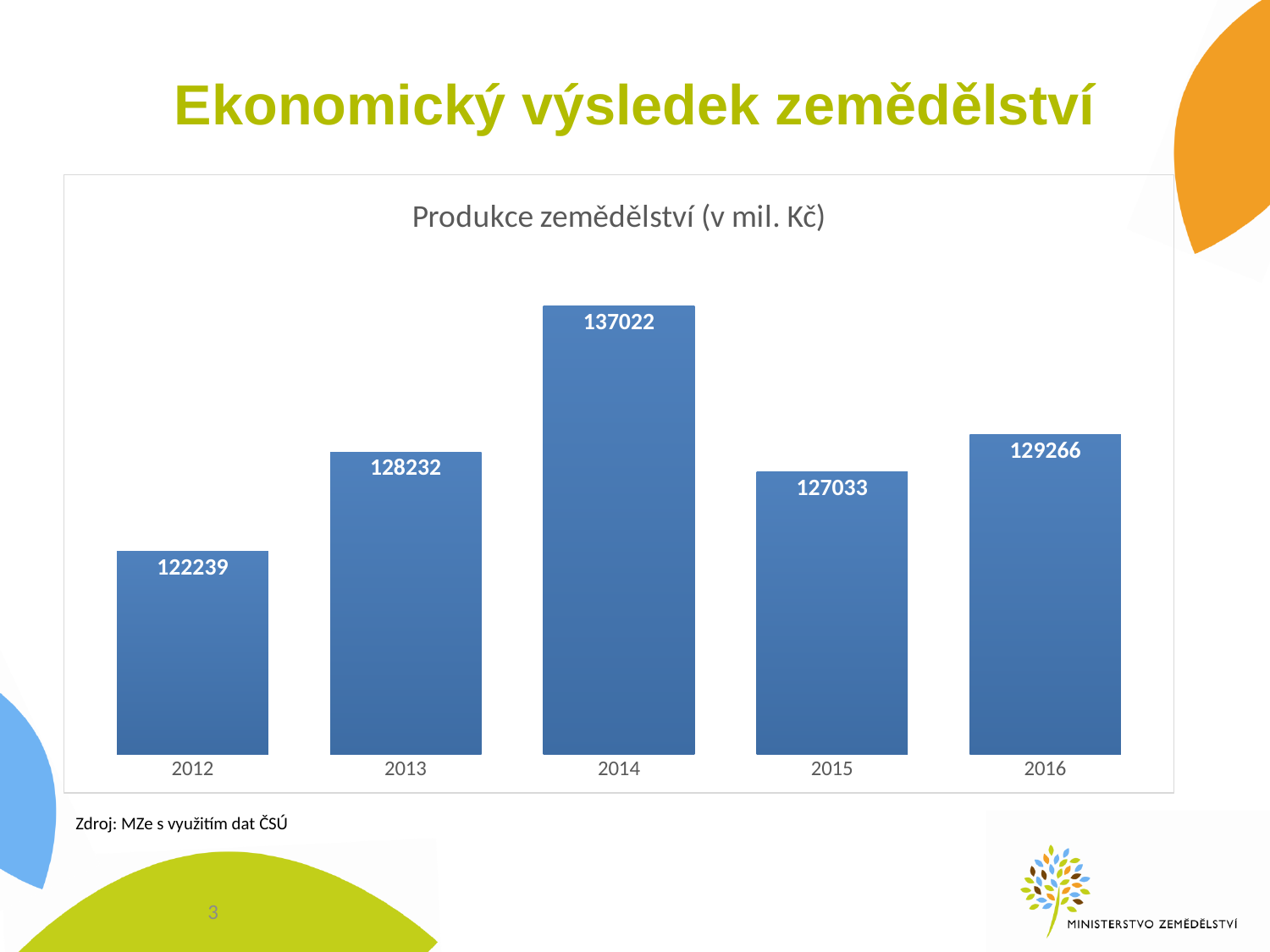
Which is larger, the value for 2016 or the value for 2013? 2016 What kind of chart is shown on the slide? bar chart What is the difference between the values for 2016 and 2015? 2233 What is the title of the chart? Produkce zemědělství (v mil. Kč) Which is larger, the value for 2013 or the value for 2015? 2013 What is the value for 2014 in the chart? 137022 What is the difference between the values for 2014 and 2012? 14783 Which year has the highest value in the chart? 2014 What is the value for 2016 in the chart? 129266 What is the value for 2012 in the chart? 122239 How many years are shown in the chart? 5 Which year has the lowest value in the chart? 2012